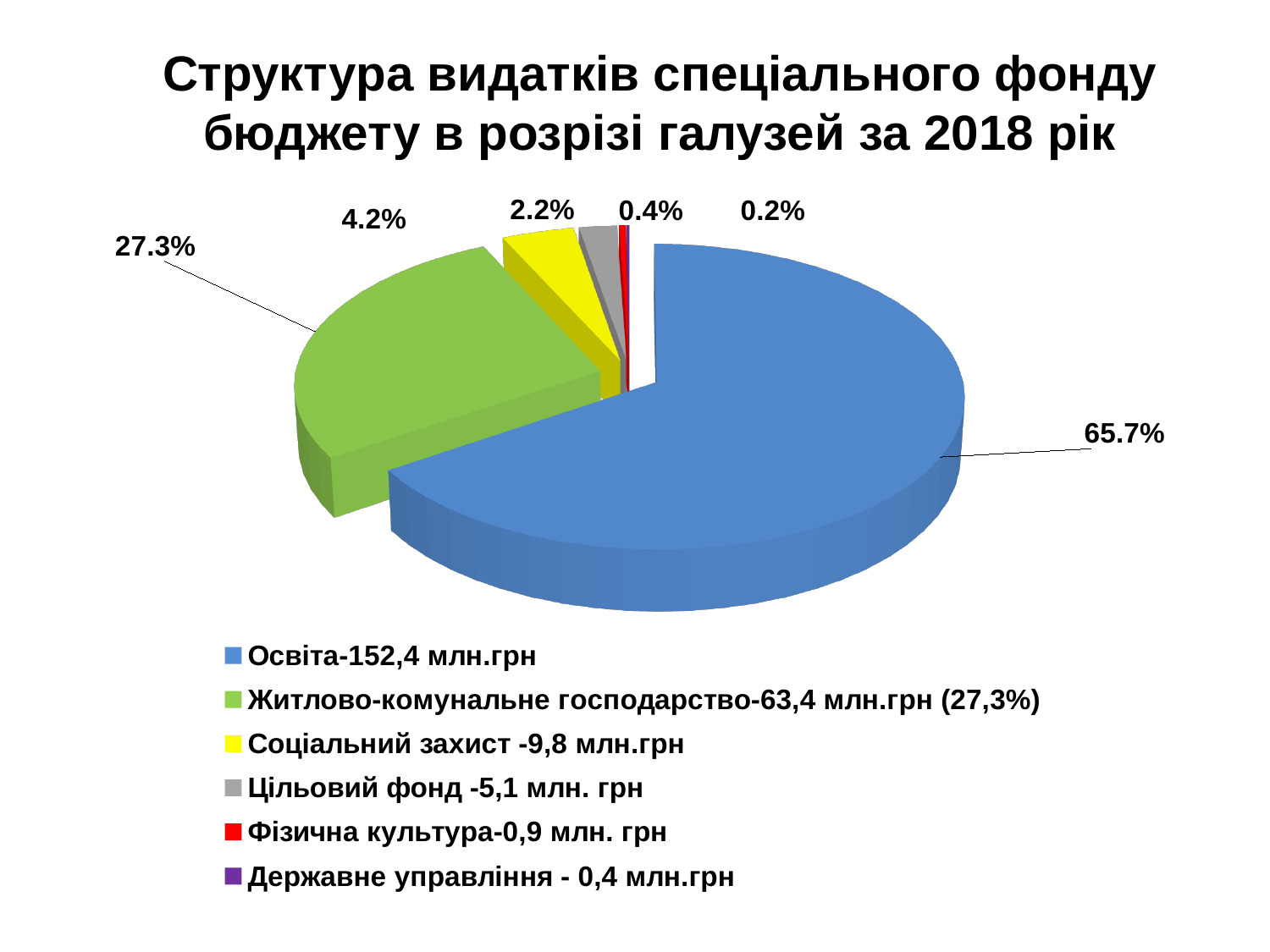
Which slice is larger, Соціальний захист or Цільовий фонд? Соціальний захист What colour is the slice for Фізична культура? red According to the legend, what amount in млн.грн is given for Освіта? 152,4 млн.грн Which category has the largest slice of the pie? Освіта What share of the pie does Освіта account for? 65.7% What share of the pie does Цільовий фонд account for? 2.2% What kind of chart is shown on the slide? pie chart What is the difference in percentage points between the Освіта slice and the Житлово-комунальне господарство slice? 38.4 How many slices does the pie chart have? 6 What share of the pie does Житлово-комунальне господарство account for? 27.3% Which category has the smallest slice of the pie? Державне управління